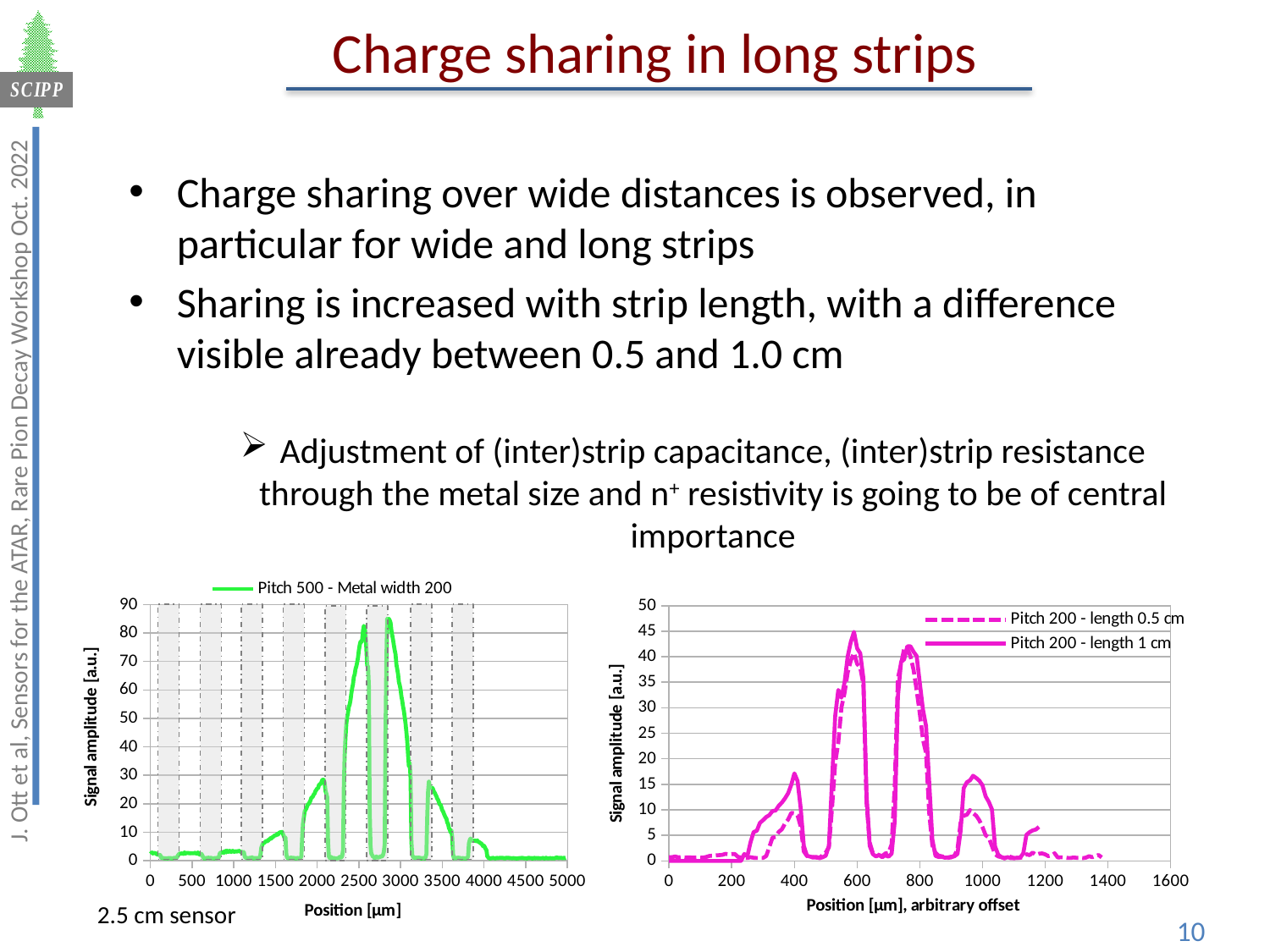
In the left chart, is the peak of the signal amplitude near position 2100 µm greater or less than 20? greater What type of chart is the left chart on the slide? line chart In the left chart, is the highest peak of the signal amplitude greater or less than 80? greater In the right chart, is the highest peak of the 'Pitch 200 - length 1 cm' series greater or less than 40? greater In the right chart, at position 400 µm, which series has the larger signal amplitude: 'Pitch 200 - length 0.5 cm' or 'Pitch 200 - length 1 cm'? Pitch 200 - length 1 cm How many series does the legend of the right chart list? 2 What is the x-axis title of the right chart? Position [µm], arbitrary offset What is the series name shown in the legend of the left chart? Pitch 500 - Metal width 200 In the right chart, at position 1000 µm, which series has the larger signal amplitude: 'Pitch 200 - length 0.5 cm' or 'Pitch 200 - length 1 cm'? Pitch 200 - length 1 cm